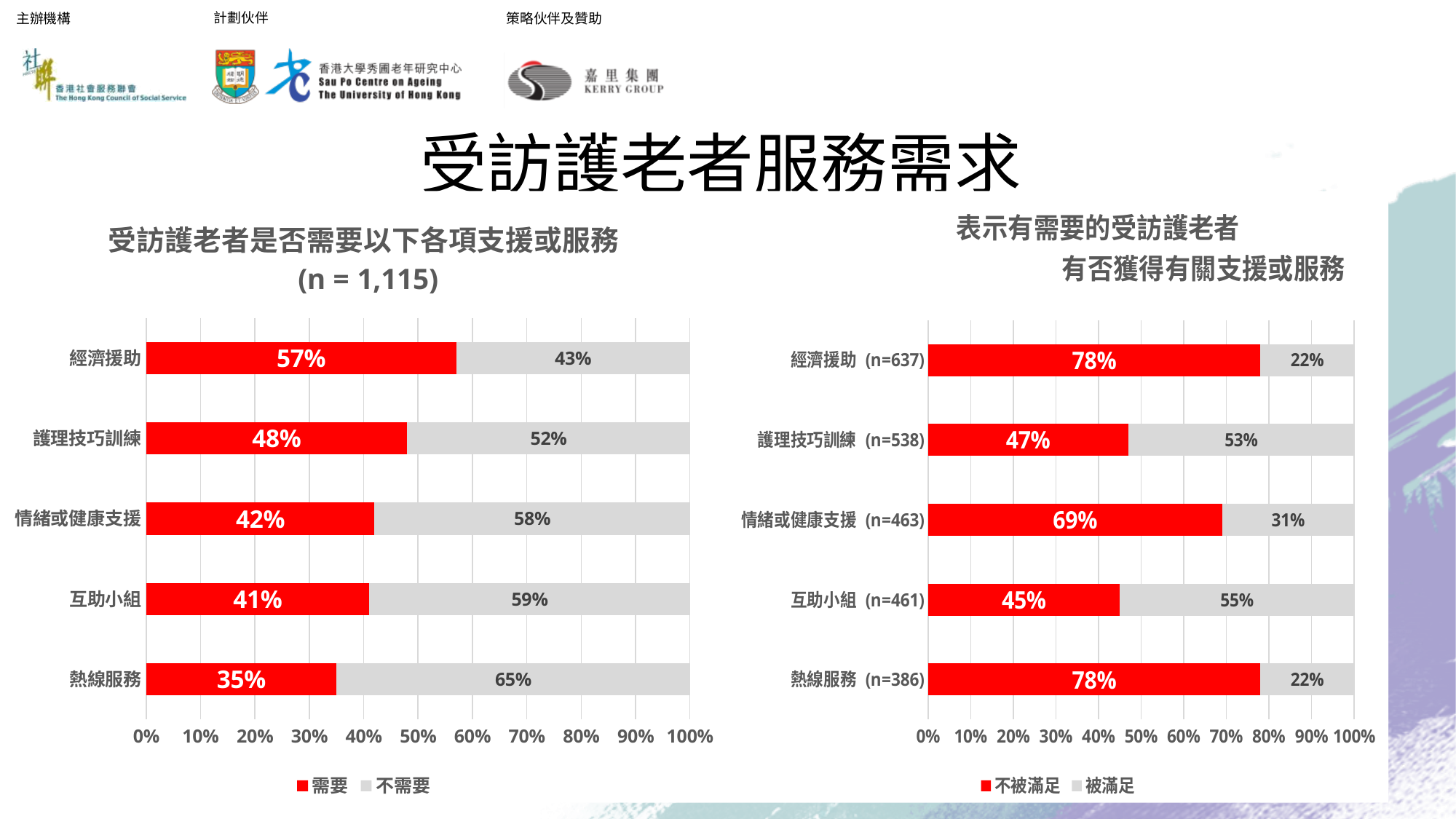
In the left chart (受訪護老者是否需要以下各項支援或服務), what is the difference between the 需要 values for 經濟援助 and 護理技巧訓練? 9% In the left chart (受訪護老者是否需要以下各項支援或服務), which service has the lowest 需要 percentage? 熱線服務 In the right chart (表示有需要的受訪護老者有否獲得有關支援或服務), what is the 不被滿足 value for 情緒或健康支援? 69% How many service categories are shown in the left chart (受訪護老者是否需要以下各項支援或服務)? 5 In the right chart (表示有需要的受訪護老者有否獲得有關支援或服務), which service has the lowest 不被滿足 percentage? 互助小組 In the left chart (受訪護老者是否需要以下各項支援或服務), what percentage of respondents said they need 經濟援助? 57% In the left chart (受訪護老者是否需要以下各項支援或服務), which service has the highest 需要 percentage? 經濟援助 In the right chart (表示有需要的受訪護老者有否獲得有關支援或服務), what is the 被滿足 value for 護理技巧訓練? 53% In the right chart (表示有需要的受訪護老者有否獲得有關支援或服務), is the 不被滿足 value larger for 經濟援助 or 互助小組? 經濟援助 What type of chart is the left chart (受訪護老者是否需要以下各項支援或服務)? Stacked bar chart In the left chart (受訪護老者是否需要以下各項支援或服務), what is the 不需要 value for 熱線服務? 65% How many series does the legend of the right chart (表示有需要的受訪護老者有否獲得有關支援或服務) list? 2